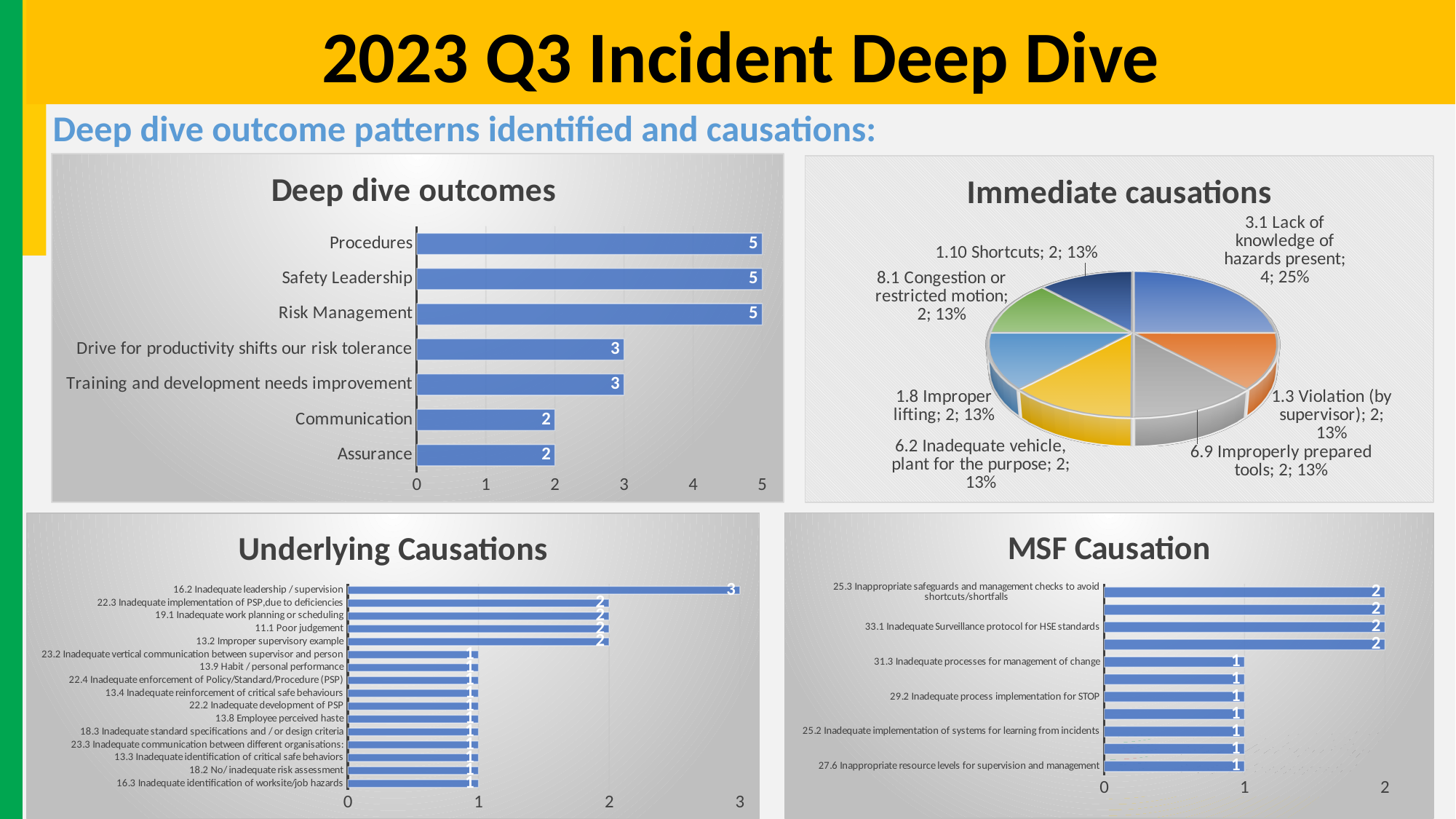
In the Underlying Causations chart, which category has the highest value? 16.2 Inadequate leadership / supervision In the Deep dive outcomes chart, what is the value for Drive for productivity shifts our risk tolerance? 3 In the Immediate causations chart, what is the value for 1.8 Improper lifting? 2 In the MSF Causation chart, what is the value for 31.3 Inadequate processes for management of change? 1 In the Immediate causations chart, which slice is the largest? 3.1 Lack of knowledge of hazards present In the Deep dive outcomes chart, which is larger, Risk Management or Training and development needs improvement? Risk Management In the Deep dive outcomes chart, what is the difference between the values for Procedures and Assurance? 3 In the Deep dive outcomes chart, how many categories are plotted? 7 What kind of chart is the Immediate causations chart? Pie chart In the Immediate causations chart, what share of the pie is 3.1 Lack of knowledge of hazards present? 25% In the Deep dive outcomes chart, what is the value for Communication? 2 In the Underlying Causations chart, what is the value for 11.1 Poor judgement? 2